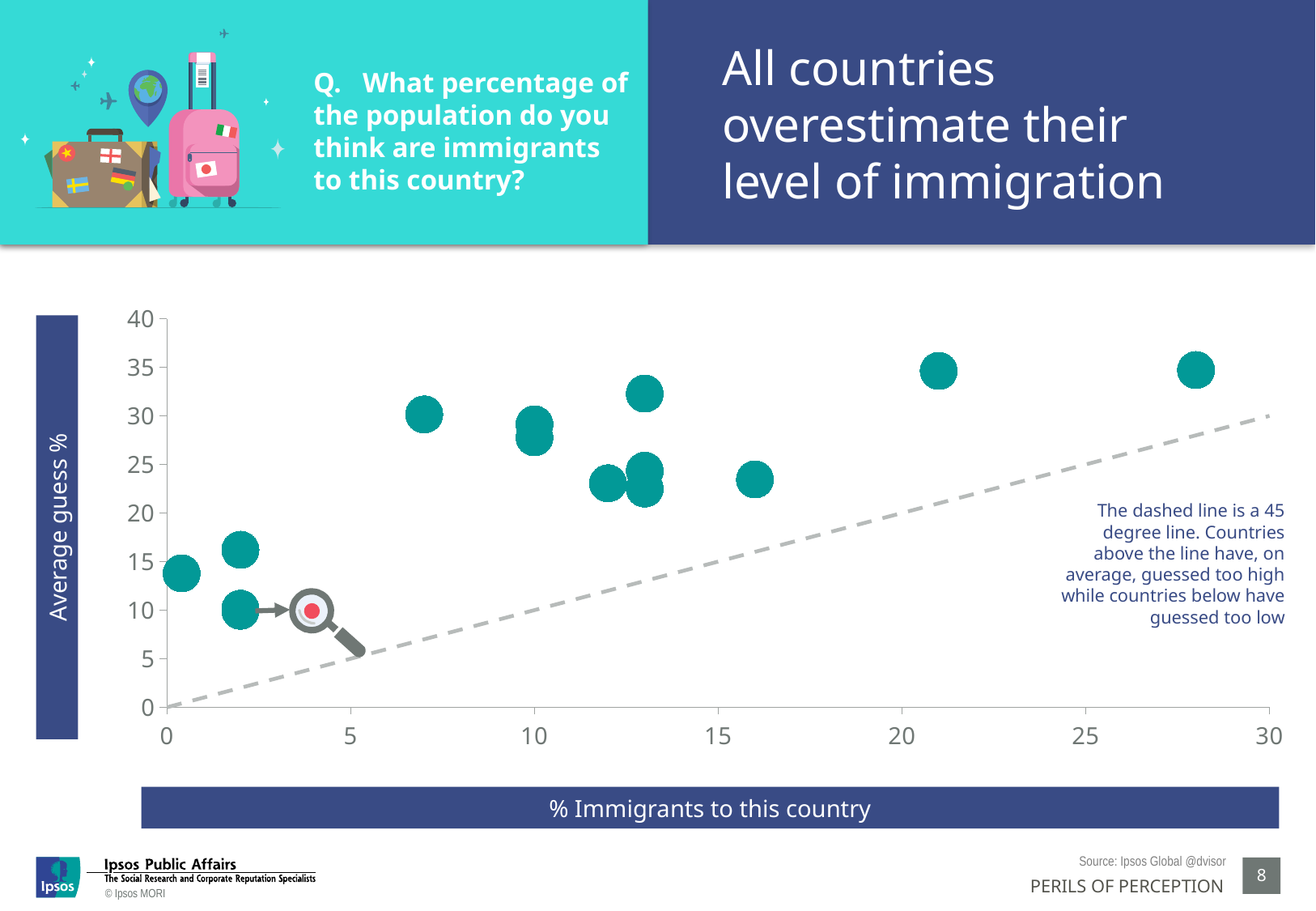
Is the lowest average guess plotted on the chart greater or less than 15? less Do the plotted points lie above or below the dashed 45 degree line? above What kind of chart is shown on the slide? scatter chart What is the highest value shown on the vertical axis of the chart? 40 Is the largest % immigrants value plotted on the chart greater or less than 25? greater Do average guesses generally rise or fall as the % immigrants to the country increases? rise What does the dashed line on the chart represent? a 45 degree line What is the label of the horizontal axis of the chart? % Immigrants to this country